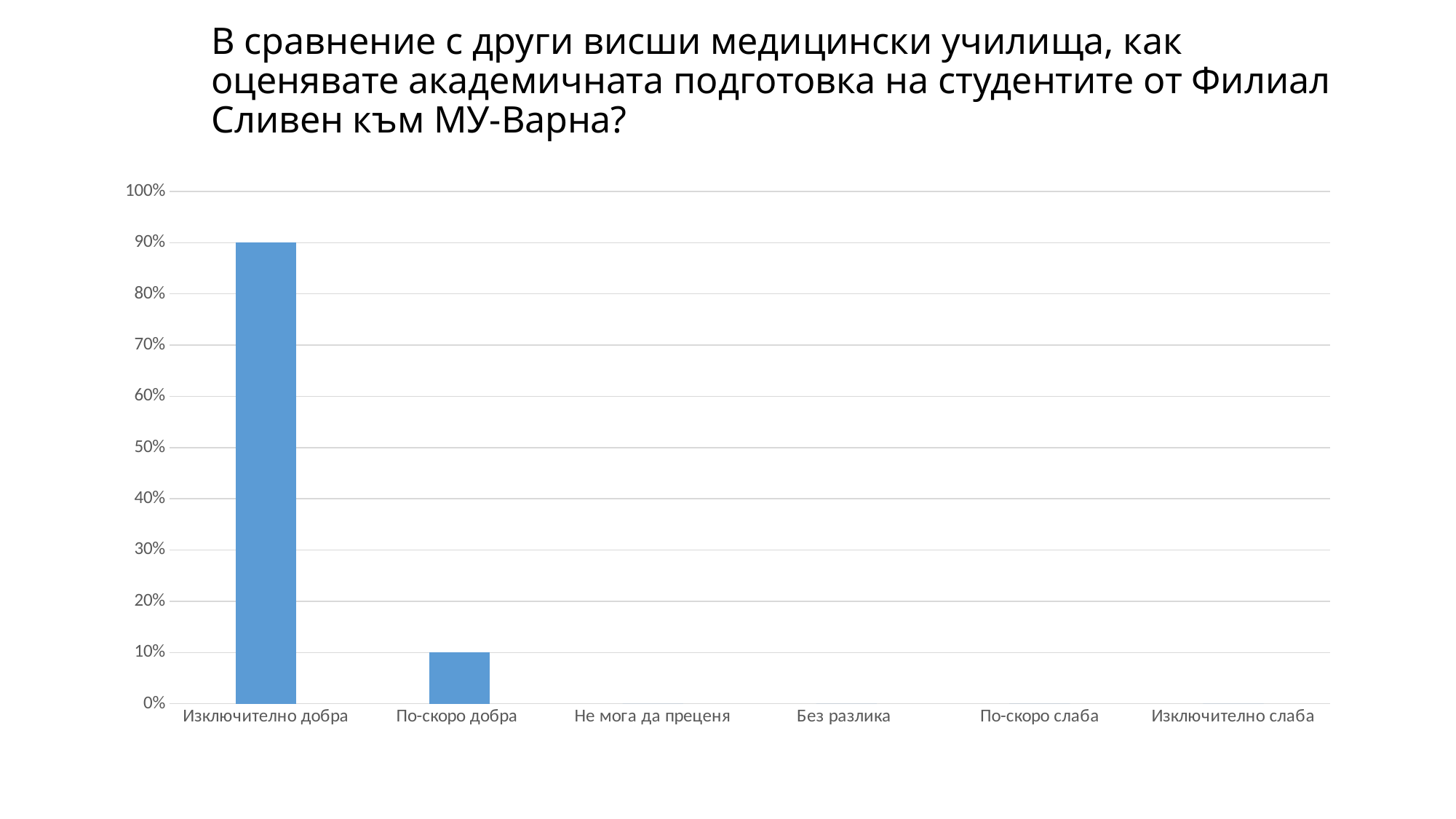
What is the highest value shown on the vertical axis? 100% What colour are the bars in the chart? blue Is the value for Изключително добра greater or less than 50%? greater What is the value for Без разлика? 0% What is the difference between the values for Изключително добра and По-скоро добра? 80% Is the value for По-скоро добра greater or less than 20%? less Which of the two, Изключително добра or По-скоро добра, has the larger value? Изключително добра What type of chart is shown on the slide? bar chart How many categories are shown on the x axis of the chart? 6 What is the value for Изключително добра? 90% What is the value for По-скоро добра? 10% Which category has the highest value? Изключително добра